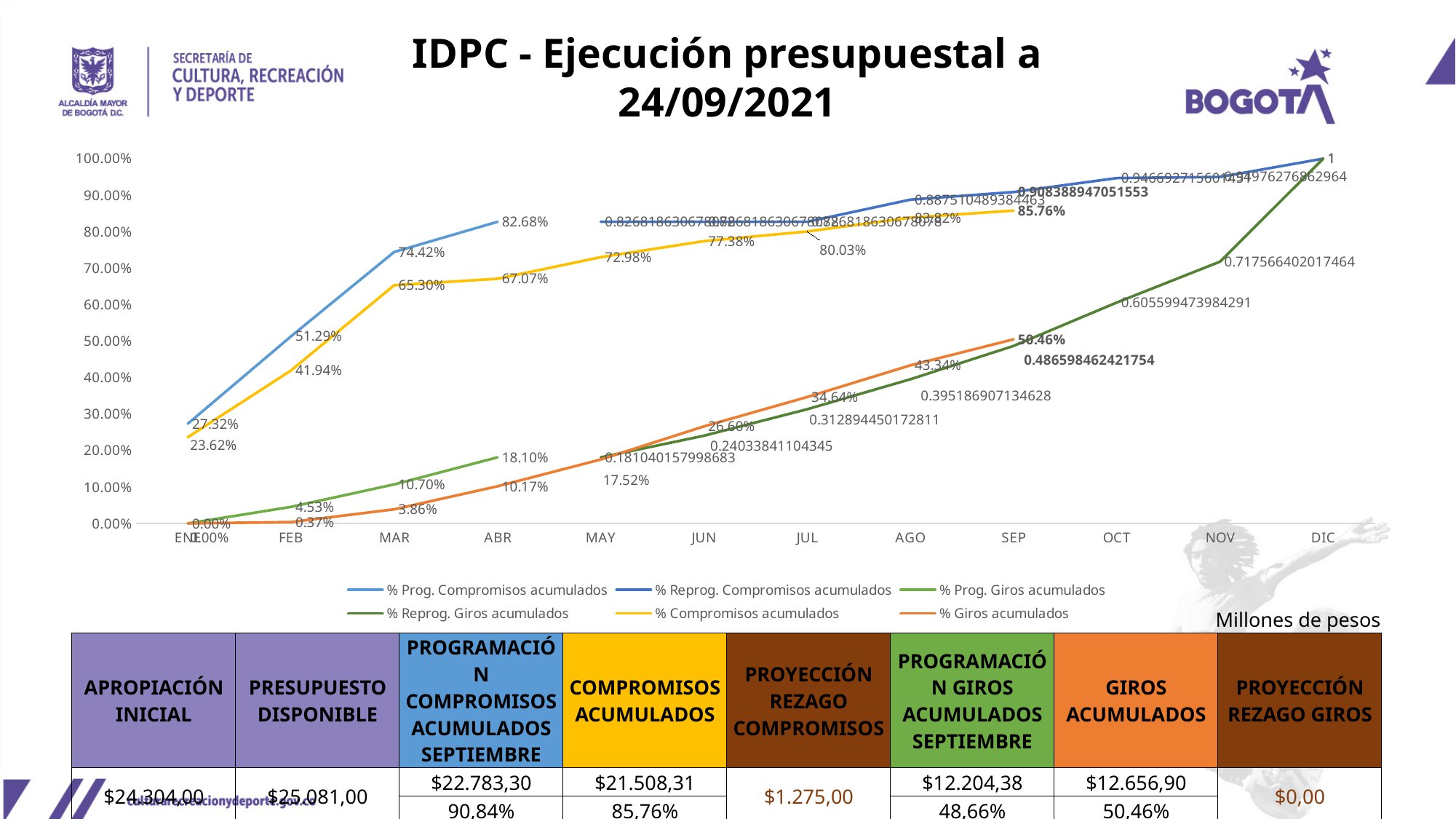
How many series does the chart legend list? 6 What kind of chart is shown on the slide? line chart What is the value of % Prog. Giros acumulados in FEB? 4.53% What is the value of % Giros acumulados in SEP? 50.46% What is the value of % Compromisos acumulados in SEP? 85.76% How many months are shown along the x axis of the chart? 12 In which month does % Compromisos acumulados reach its highest labelled value? SEP Does % Giros acumulados rise or fall from ENE to SEP? rise What is the difference between % Compromisos acumulados and % Giros acumulados in SEP? 35.30% In MAR, which is higher: % Prog. Compromisos acumulados or % Compromisos acumulados? % Prog. Compromisos acumulados What is the value of % Prog. Compromisos acumulados in ABR? 82.68% Is the value for % Reprog. Giros acumulados in NOV greater or less than 70.00%? greater